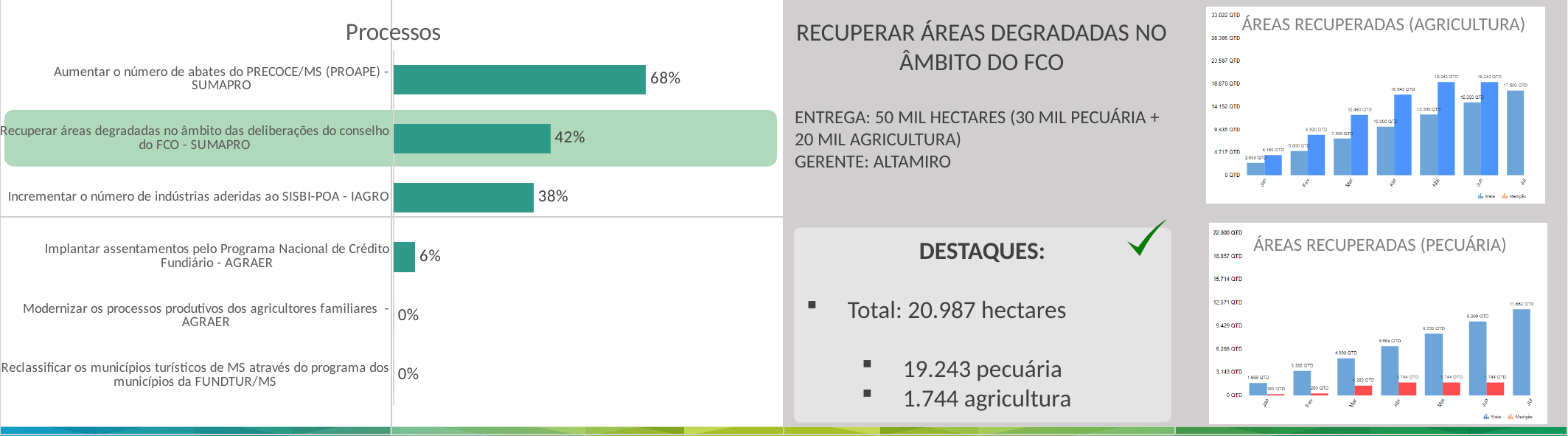
On the 'Processos' chart, how many categories have a value of 0%? 2 What kind of chart is the 'Processos' chart? Bar chart What is the title of the lower chart on the right side of the slide? ÁREAS RECUPERADAS (PECUÁRIA) On the 'Processos' chart, what is the value for 'Implantar assentamentos pelo Programa Nacional de Crédito Fundiário - AGRAER'? 6% On the 'Processos' chart, what is the difference between the values for 'Aumentar o número de abates do PRECOCE/MS (PROAPE) - SUMAPRO' and 'Recuperar áreas degradadas no âmbito das deliberações do conselho do FCO - SUMAPRO'? 26% On the 'Processos' chart, what is the value for 'Aumentar o número de abates do PRECOCE/MS (PROAPE) - SUMAPRO'? 68% On the 'Processos' chart, what is the value for 'Incrementar o número de indústrias aderidas ao SISBI-POA - IAGRO'? 38% On the 'Processos' chart, what is the difference between the values for 'Incrementar o número de indústrias aderidas ao SISBI-POA - IAGRO' and 'Implantar assentamentos pelo Programa Nacional de Crédito Fundiário - AGRAER'? 32% On the 'Processos' chart, how many categories are shown? 6 On the 'Processos' chart, what is the value for 'Recuperar áreas degradadas no âmbito das deliberações do conselho do FCO - SUMAPRO'? 42% On the 'Processos' chart, which is larger: the value for 'Recuperar áreas degradadas no âmbito das deliberações do conselho do FCO - SUMAPRO' or for 'Incrementar o número de indústrias aderidas ao SISBI-POA - IAGRO'? Recuperar áreas degradadas no âmbito das deliberações do conselho do FCO - SUMAPRO On the 'Processos' chart, which category has the highest value? Aumentar o número de abates do PRECOCE/MS (PROAPE) - SUMAPRO